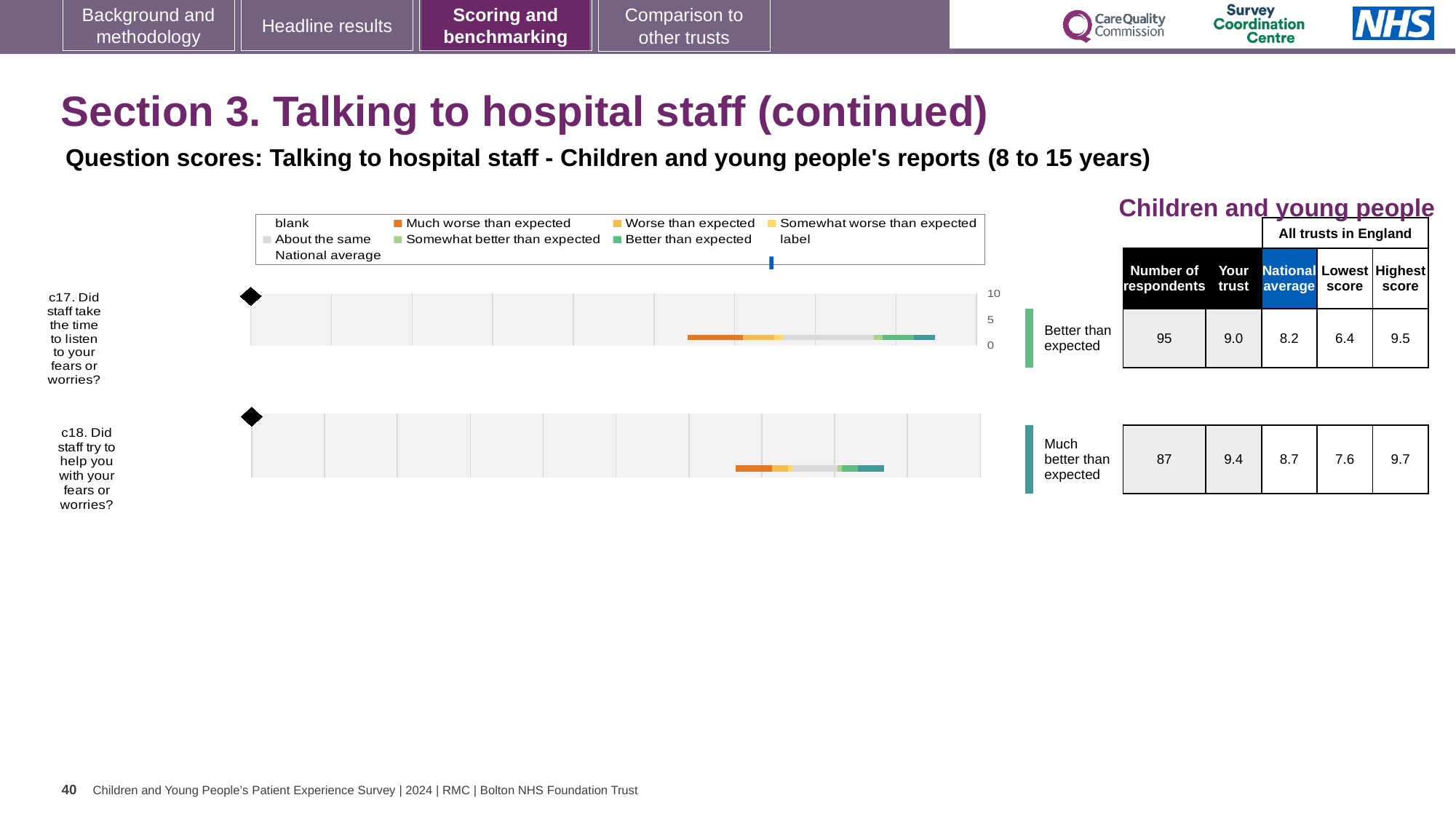
What benchmark category is shown for c18? Much better than expected What is the 'Your trust' score for c18 (Did staff try to help you with your fears or worries?)? 9.4 How many questions are plotted on the chart? 2 Which question has the higher 'Your trust' score, c17 or c18? c18 What is the difference between the highest and lowest scores for c18? 2.1 By how much does the trust's score for c17 exceed the national average? 0.8 What is the number of respondents for c17 (Did staff take the time to listen to your fears or worries?)? 95 What is the lowest score among all trusts in England for c17? 6.4 What kind of chart is used to show the question scores for c17 and c18? bar chart What benchmark category is shown for c17? Better than expected What is the national average score for c17? 8.2 What is the highest score among all trusts in England for c18? 9.7